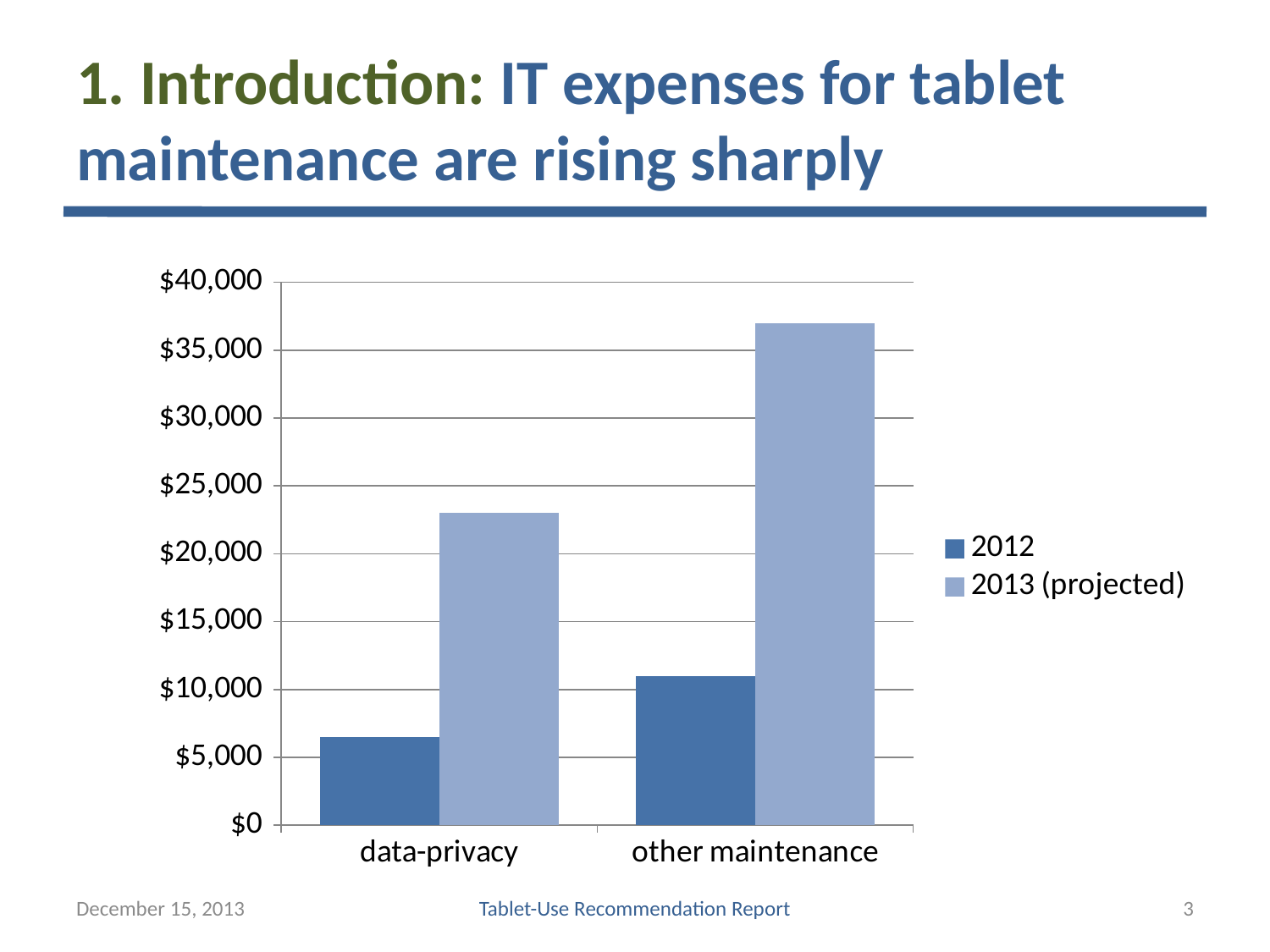
How many categories are shown on the x axis? 2 Is the 2013 (projected) value for data-privacy greater or less than $20,000? greater Is the 2013 (projected) value for other maintenance greater or less than $35,000? greater Which is larger: the 2012 value for other maintenance or the 2013 (projected) value for data-privacy? 2013 (projected) value for data-privacy Is the 2012 value for data-privacy greater or less than $10,000? less Which category has the highest 2013 (projected) value? other maintenance For data-privacy, which is larger: the 2012 value or the 2013 (projected) value? 2013 (projected) What kind of chart is shown on the slide? bar chart How many series does the legend list? 2 Which series does the legend list after 2012? 2013 (projected) Which category has the lowest 2012 value? data-privacy